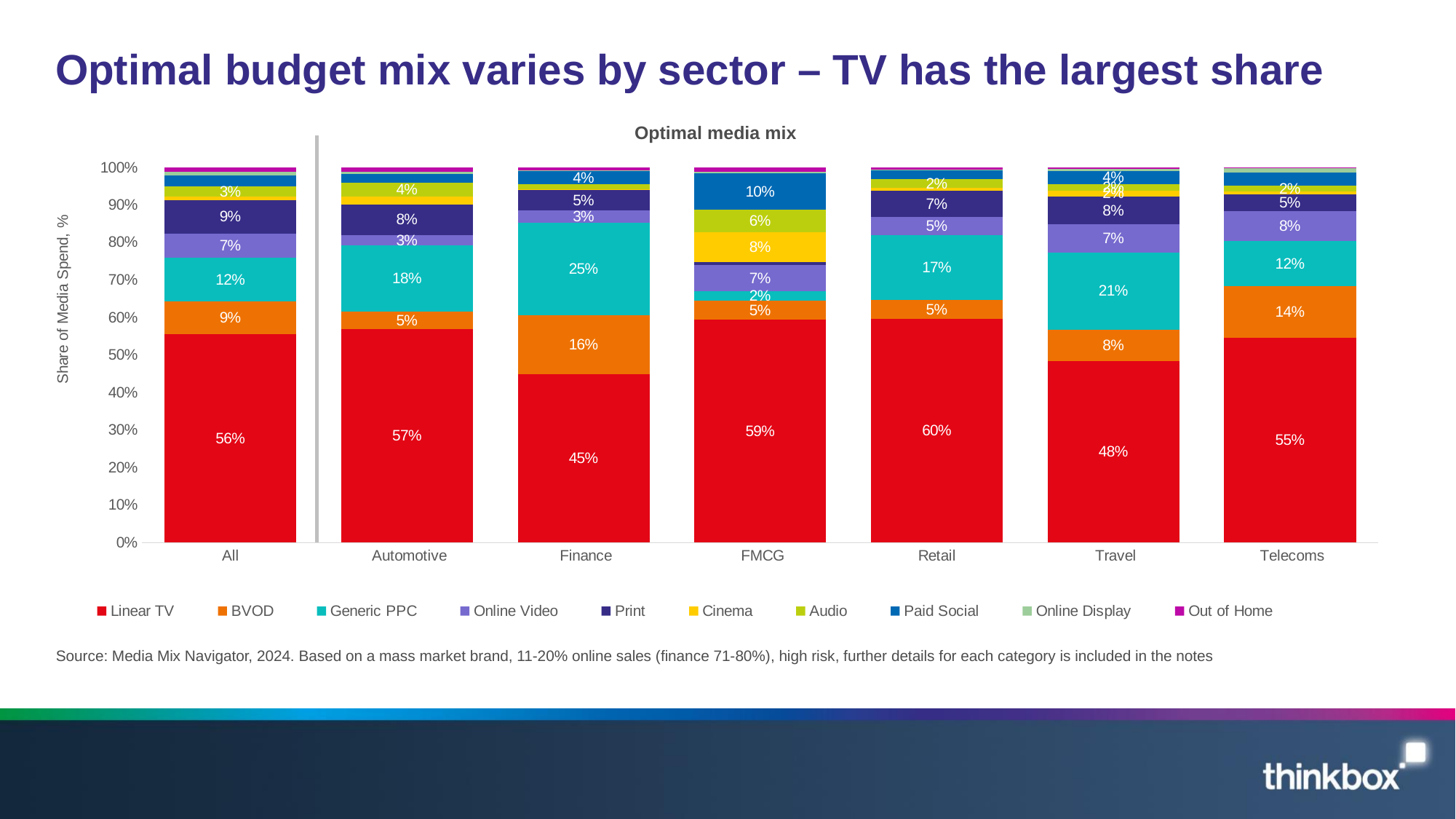
What is the Cinema share for the FMCG sector? 8% What is the Generic PPC share for the Travel sector? 21% Which sector has the lowest Linear TV share? Finance Which is larger, the BVOD share for Finance or the BVOD share for Telecoms? Finance What is the difference between the Generic PPC share for Finance and for Automotive? 7% What is the Linear TV share for the Finance sector? 45% How many series does the legend list? 10 What is the BVOD share for the Telecoms sector? 14% What kind of chart is shown on the slide? Stacked bar chart Which sector has the highest Linear TV share? Retail How many sectors are shown on the x axis? 7 What is the Paid Social share for the FMCG sector? 10%